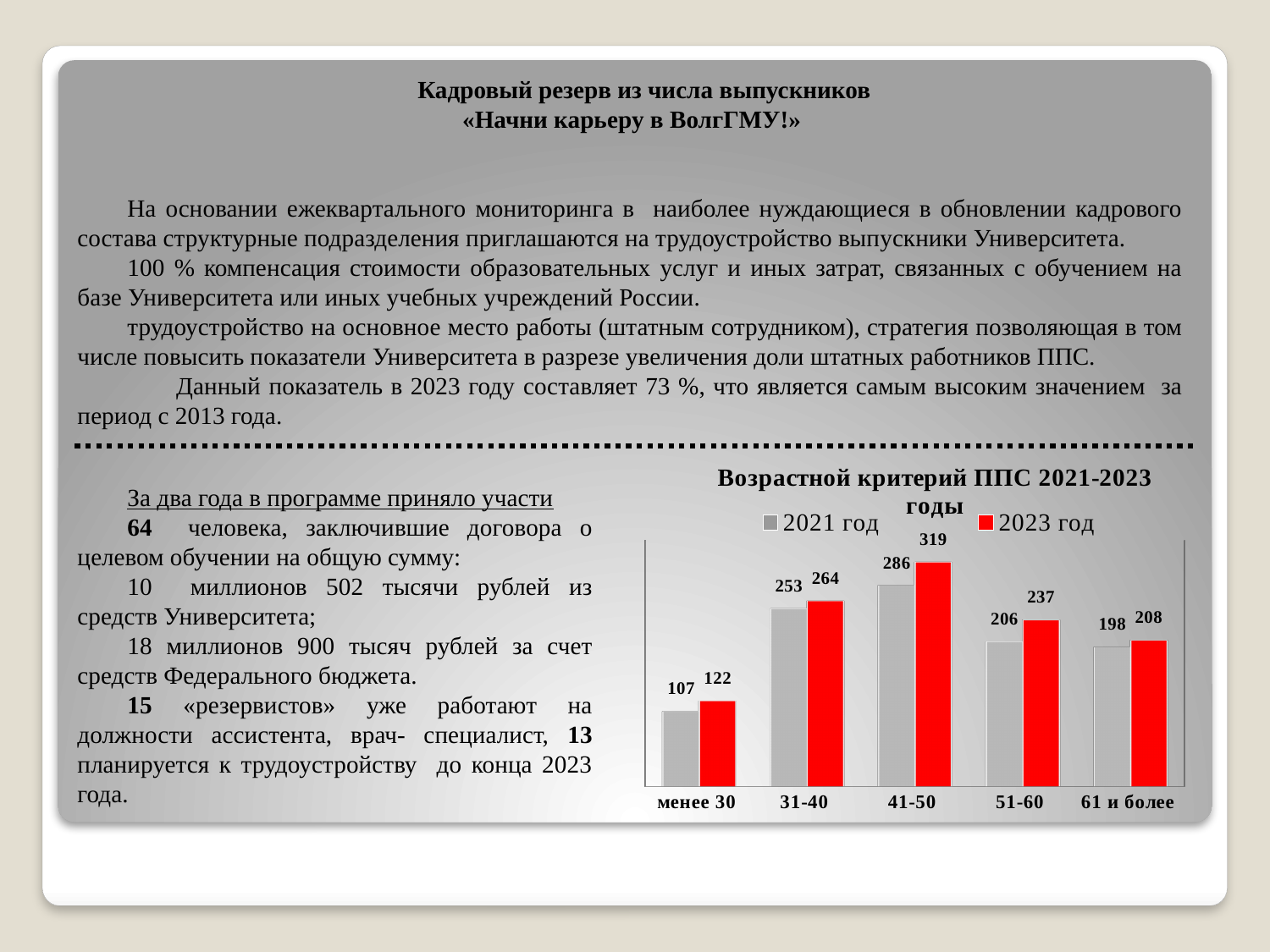
How many age groups are shown on the x axis of the chart? 5 Which age group has the highest value in the 2021 год series? 41-50 What kind of chart is shown on the slide? bar chart Which age group has the lowest value in the 2023 год series? менее 30 What is the difference between the 2023 год and 2021 год values for the 61 и более age group? 10 Which is larger: the 2021 год value for 31-40 or the 2021 год value for 51-60? 31-40 What is the difference between the 2023 год and 2021 год values for the 41-50 age group? 33 What colour are the bars for the 2023 год series? red What is the value for the 51-60 age group in the 2023 год series? 237 How many series does the chart legend list? 2 What is the value for the 41-50 age group in the 2023 год series? 319 What is the value for the менее 30 age group in the 2021 год series? 107